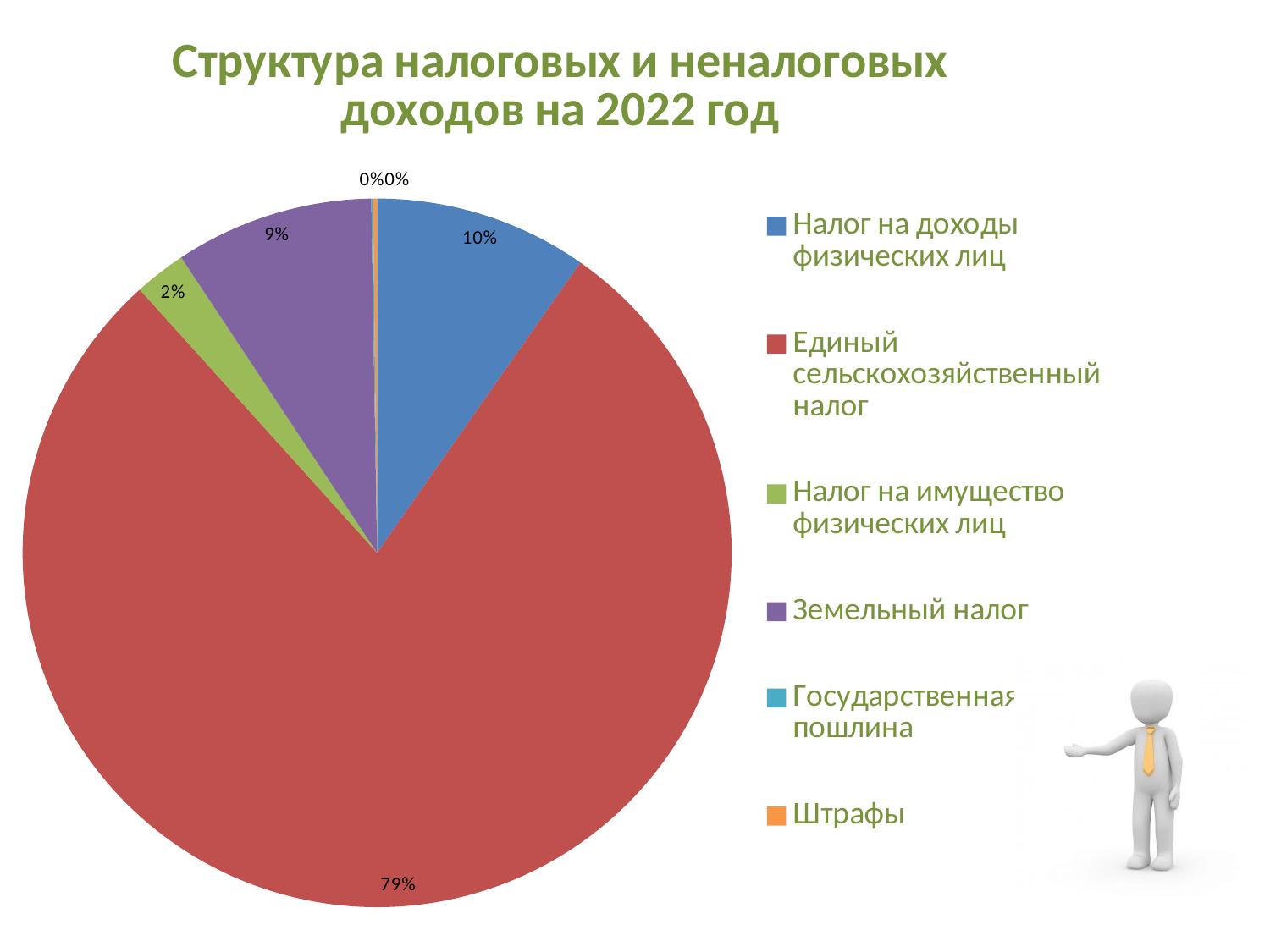
Which is larger, the share for Налог на доходы физических лиц or the share for Земельный налог? Налог на доходы физических лиц What share of the pie does Налог на имущество физических лиц have? 2% Which colour represents Земельный налог in the chart? Purple What kind of chart is shown on the slide? Pie chart What share of the pie does Налог на доходы физических лиц have? 10% What share of the pie does Единый сельскохозяйственный налог have? 79% How many categories does the legend list? 6 Which category has the largest share of the pie? Единый сельскохозяйственный налог What is the difference in percentage points between the share for Земельный налог and the share for Налог на имущество физических лиц? 7 percentage points What is the difference in percentage points between the share for Единый сельскохозяйственный налог and the share for Налог на доходы физических лиц? 69 percentage points What is the title of the chart? Структура налоговых и неналоговых доходов на 2022 год